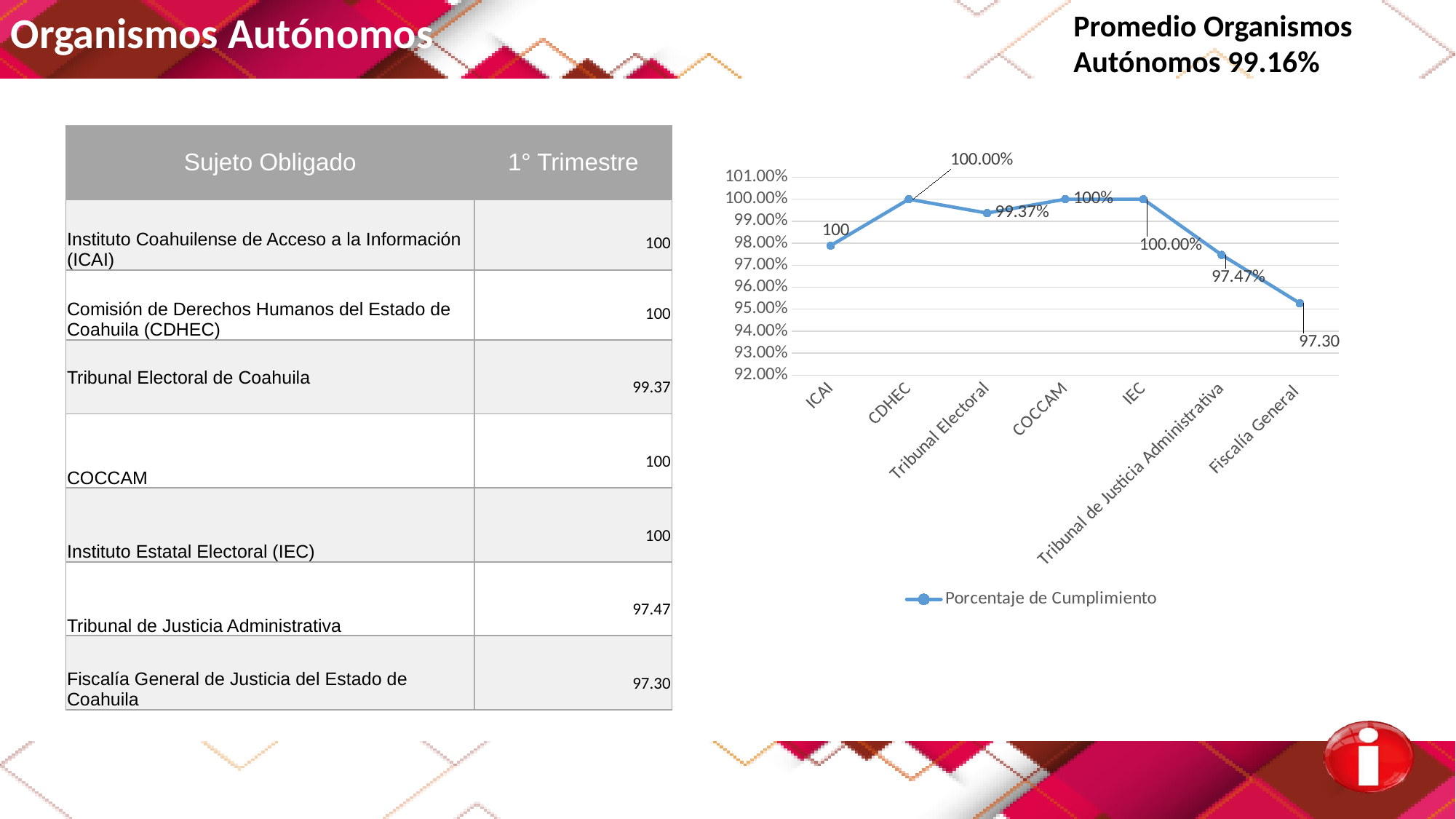
Do the values in the chart rise or fall from IEC to Fiscalía General? fall Which category has the lowest value in the chart? Fiscalía General What is the name of the series shown in the chart legend? Porcentaje de Cumplimiento What kind of chart is shown on the slide? line chart What is the data label for Fiscalía General in the chart? 97.30 What is the data label for Tribunal de Justicia Administrativa in the chart? 97.47% Which has the larger value in the chart, Tribunal Electoral or Tribunal de Justicia Administrativa? Tribunal Electoral How many categories are plotted along the x axis of the chart? 7 What is the data label for CDHEC in the chart? 100.00% What is the data label for Tribunal Electoral in the chart? 99.37% How many series does the chart legend list? 1 What is the difference between the values for CDHEC and Tribunal Electoral in the chart? 0.63%